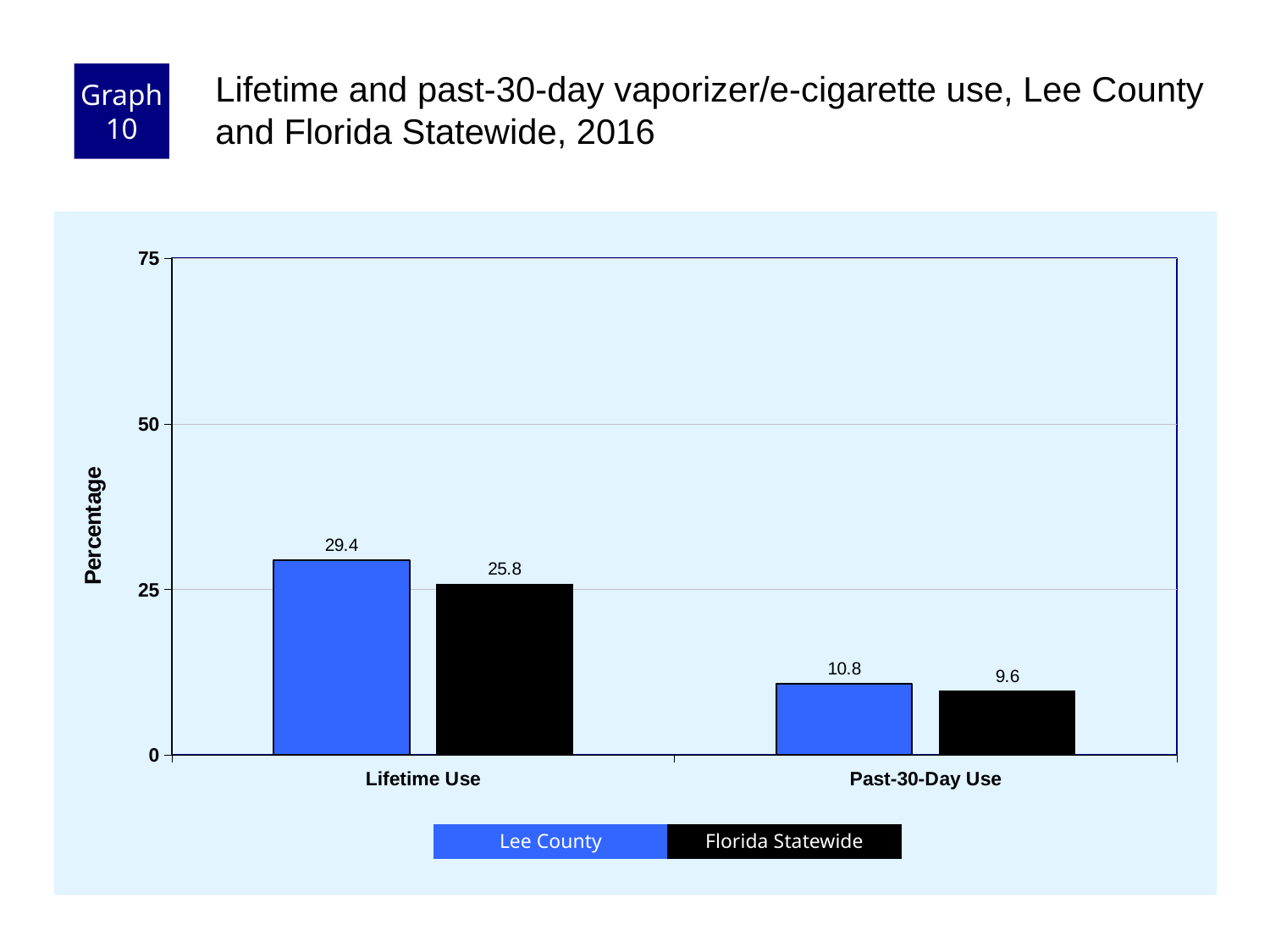
Which bar has the highest value on the chart? Lee County, Lifetime Use Is the Florida Statewide value for Lifetime Use greater or less than 25? greater What kind of chart is shown on the slide? Bar chart How many categories are shown on the x axis? 2 What is the Florida Statewide value for Past-30-Day Use? 9.6 What is the Lee County value for Lifetime Use? 29.4 How many series does the legend list? 2 What is the Florida Statewide value for Lifetime Use? 25.8 Which is larger for Past-30-Day Use, Lee County or Florida Statewide? Lee County What is the Lee County value for Past-30-Day Use? 10.8 What is the difference between the Lee County and Florida Statewide values for Lifetime Use? 3.6 Which bar has the lowest value on the chart? Florida Statewide, Past-30-Day Use